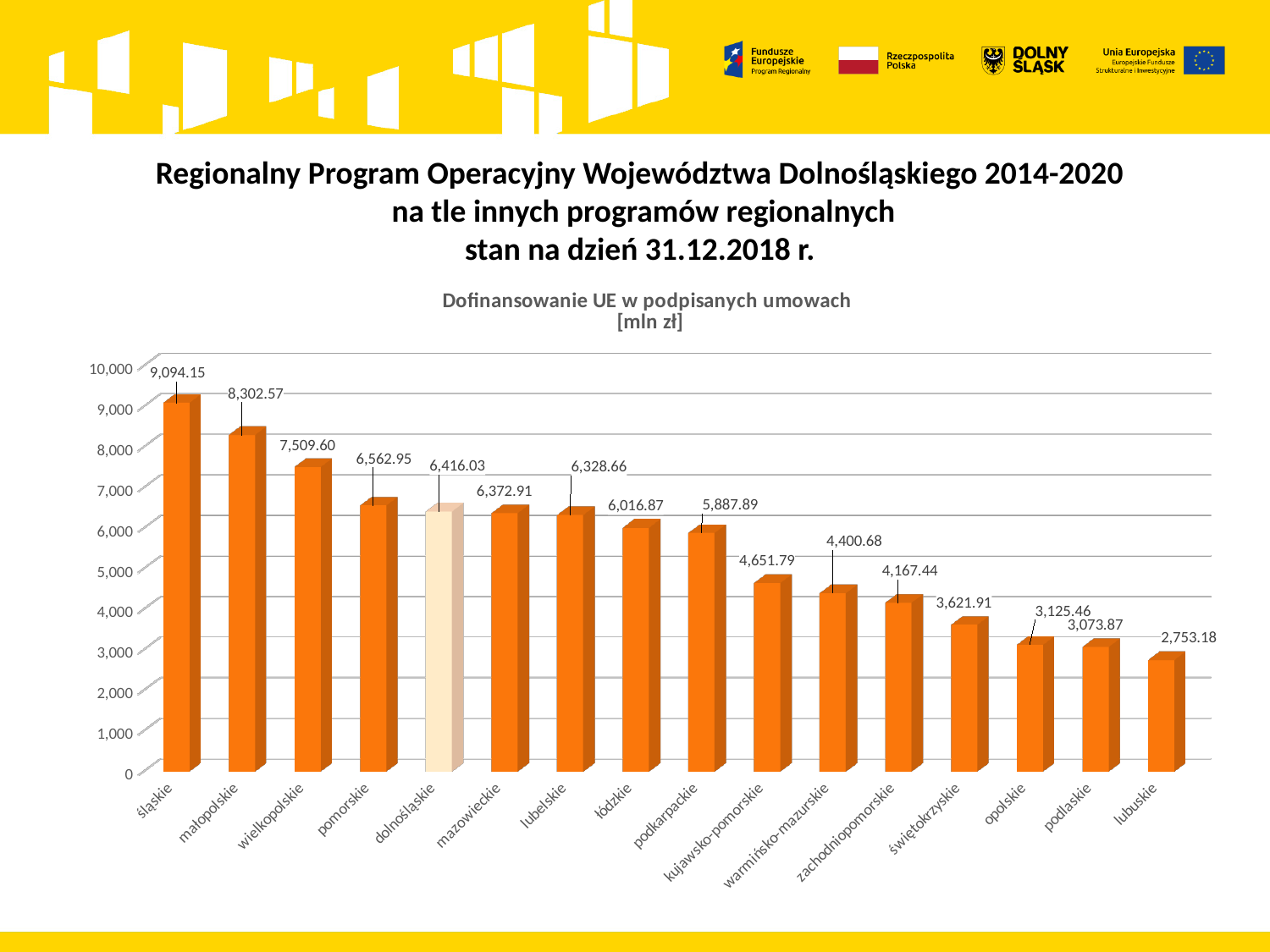
What is the difference between the values for śląskie and lubuskie? 6,340.97 What is the difference between the values for małopolskie and wielkopolskie? 792.97 What kind of chart is shown on the slide? bar chart Which category has the highest value? śląskie What is the value for kujawsko-pomorskie? 4,651.79 What is the value for dolnośląskie? 6,416.03 What is the title of the chart? Dofinansowanie UE w podpisanych umowach [mln zł] Which category has the lowest value? lubuskie What is the value for podlaskie? 3,073.87 What is the value for śląskie? 9,094.15 How many categories are shown on the x axis? 16 Which has a larger value, pomorskie or lubelskie? pomorskie